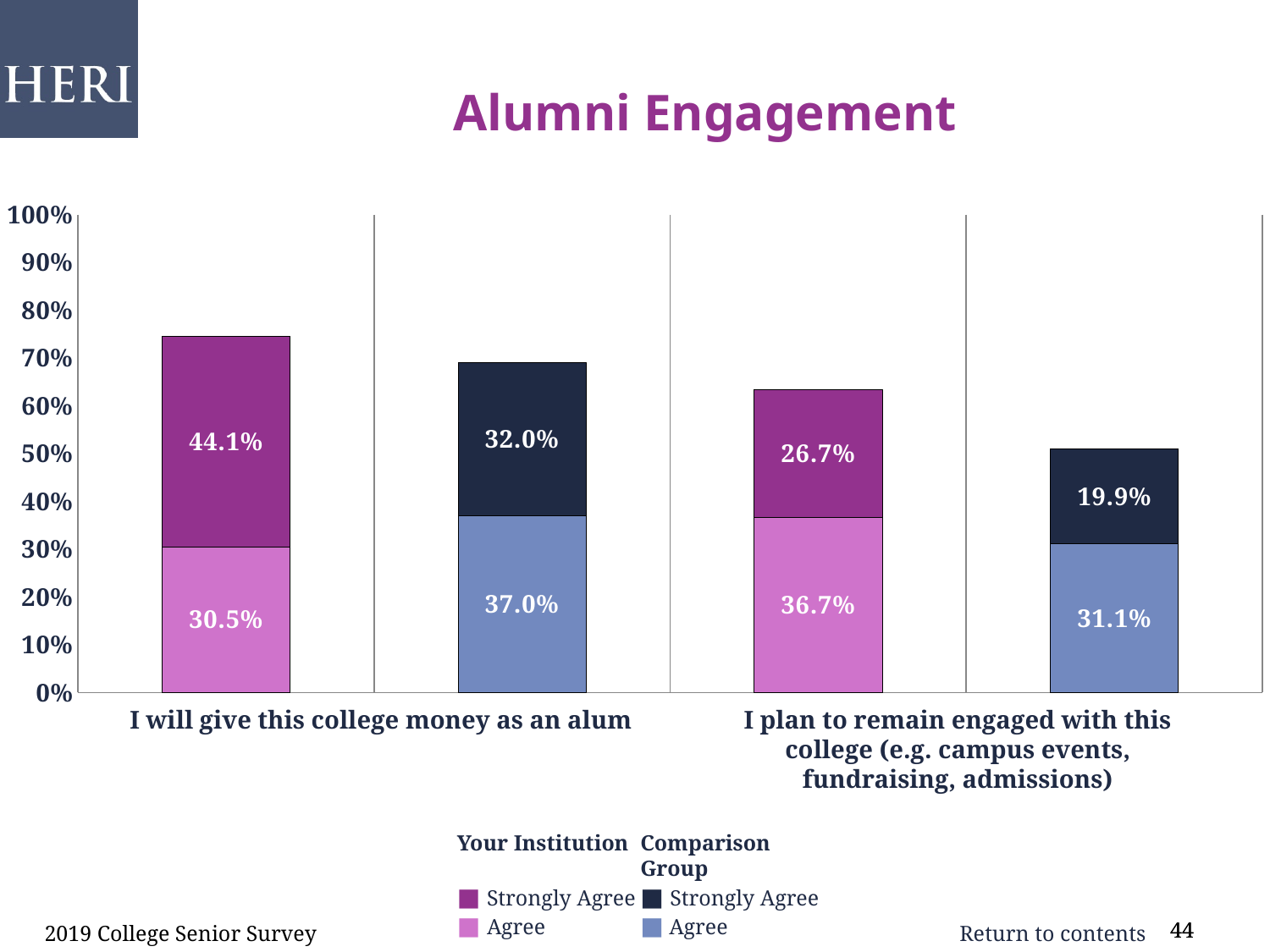
What percentage of the Comparison Group agree (not strongly) with "I plan to remain engaged with this college"? 31.1% How many entries does the legend list? 4 Is the total height of the Comparison Group bar for "I will give this college money as an alum" greater or less than 60%? greater What percentage of Your Institution students strongly agree with "I will give this college money as an alum"? 44.1% What is the total percentage (Strongly Agree plus Agree) for the Comparison Group on "I plan to remain engaged with this college"? 51.0% What percentage of the Comparison Group strongly agree with "I will give this college money as an alum"? 32.0% Which has the larger Agree percentage for "I plan to remain engaged with this college": Your Institution or the Comparison Group? Your Institution What type of chart is shown on the slide? Stacked bar chart How many survey statements (categories) are shown on the x axis? 2 Which of the four stacked bars has the lowest Strongly Agree percentage? Comparison Group, I plan to remain engaged with this college (19.9%) What is the total percentage (Strongly Agree plus Agree) for Your Institution on "I will give this college money as an alum"? 74.6% What is the difference between Your Institution's and the Comparison Group's Strongly Agree percentages for "I will give this college money as an alum"? 12.1%